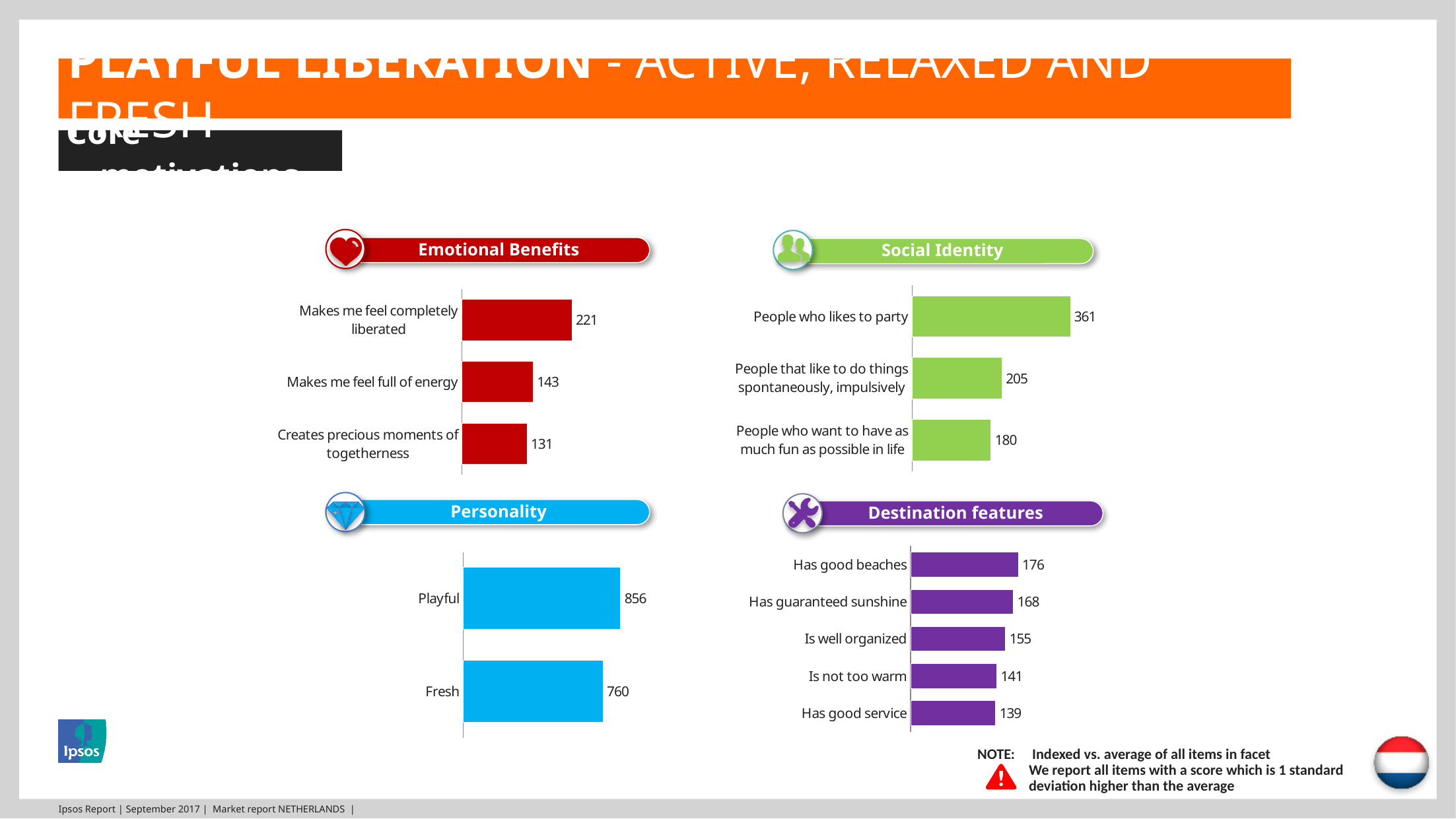
In the Personality chart, what is the value for Fresh? 760 In the Emotional Benefits chart, which category has the lowest value? Creates precious moments of togetherness In the Destination features chart, what is the value for "Is well organized"? 155 In the Destination features chart, which category has the highest value? Has good beaches In the Personality chart, which is larger, Playful or Fresh? Playful In the Emotional Benefits chart, what is the value for "Makes me feel completely liberated"? 221 What colour are the bars in the Social Identity chart? Green How many categories does the Destination features chart show? 5 In the Social Identity chart, what is the difference between "People who likes to party" and "People who want to have as much fun as possible in life"? 181 What kind of chart is the Emotional Benefits chart? Bar chart In the Social Identity chart, what is the value for "People who likes to party"? 361 In the Destination features chart, what is the difference between "Has guaranteed sunshine" and "Has good service"? 29